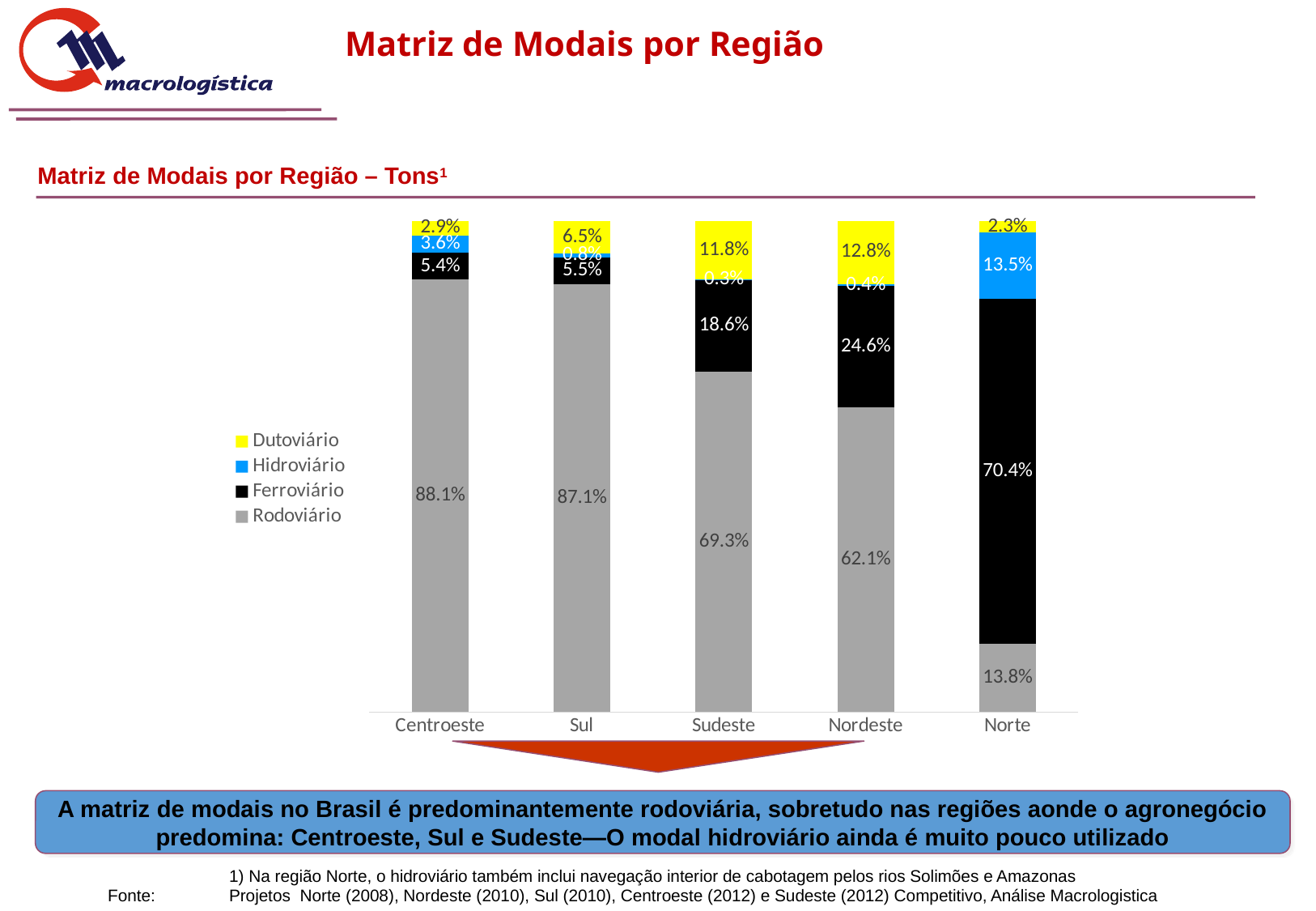
How many series does the chart legend list? 4 Which series is shown in yellow in the legend? Dutoviário What is the Hidroviário share for Norte? 13.5% What is the Ferroviário share for Norte? 70.4% Which is larger, the Dutoviário share for Sul or for Sudeste? Sudeste What is the Rodoviário share for Centroeste? 88.1% What is the difference between the Rodoviário shares of Sudeste and Nordeste? 7.2% What is the Dutoviário share for Nordeste? 12.8% Which region has the highest Ferroviário share? Norte How many regions are shown on the x axis of the chart? 5 Which region has the lowest Rodoviário share? Norte What type of chart is shown on the slide? Stacked bar chart